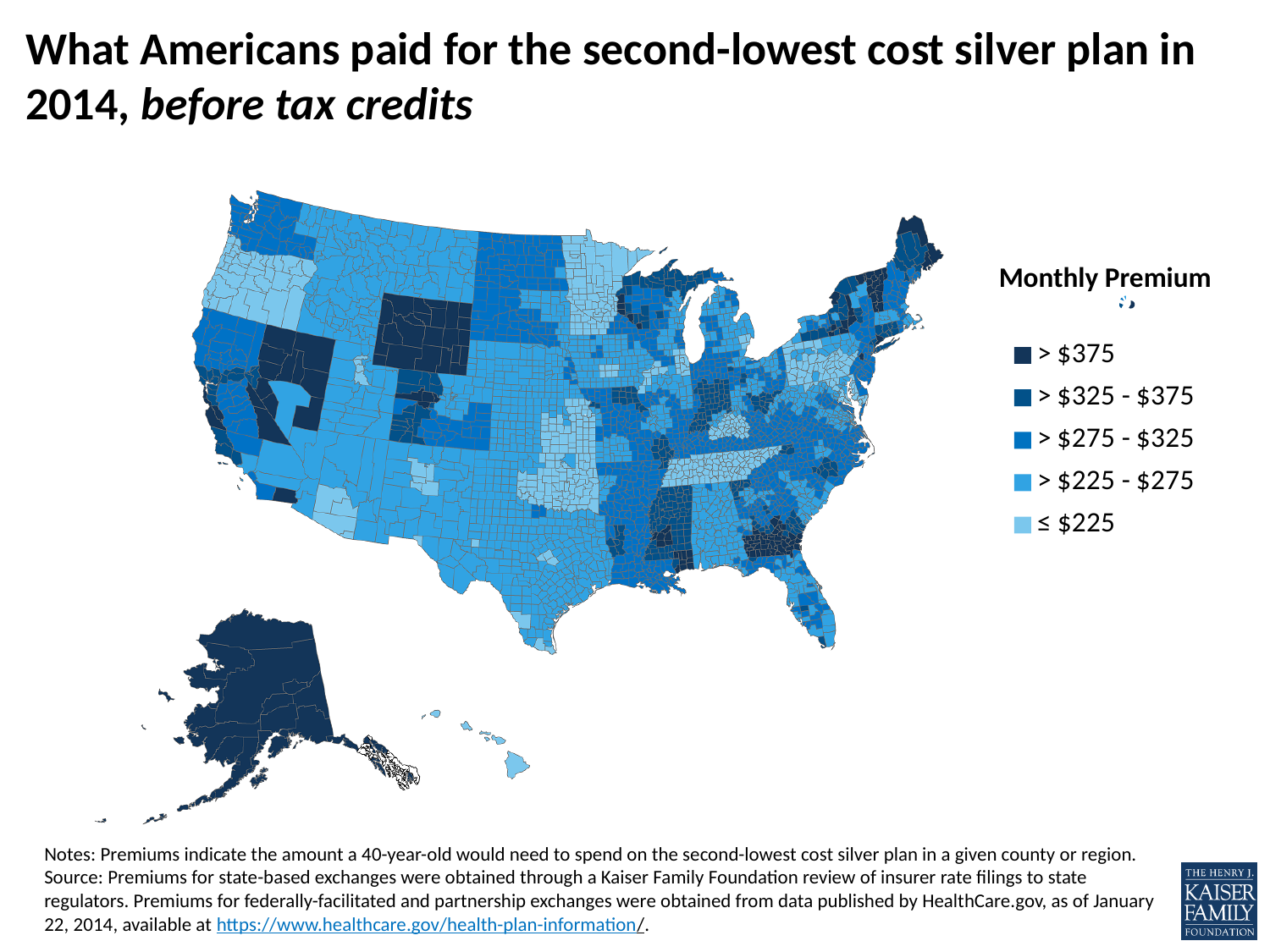
What premium range does the legend category between > $275 - $325 and > $375 cover? > $325 - $375 According to the map, is the monthly premium in Hawaii greater or less than $225? less What kind of chart is shown on the slide? A map (choropleth map) Which state has the higher monthly premium on the map, Alaska or Hawaii? Alaska Which legend category represents the lowest monthly premiums? ≤ $225 Which legend category is shown in the lightest shade of blue? ≤ $225 What is the title of the legend on the map? Monthly Premium According to the map, is the monthly premium in Alaska greater or less than $375? greater How many premium categories does the legend list? 5 Which legend category represents the highest monthly premiums? > $375